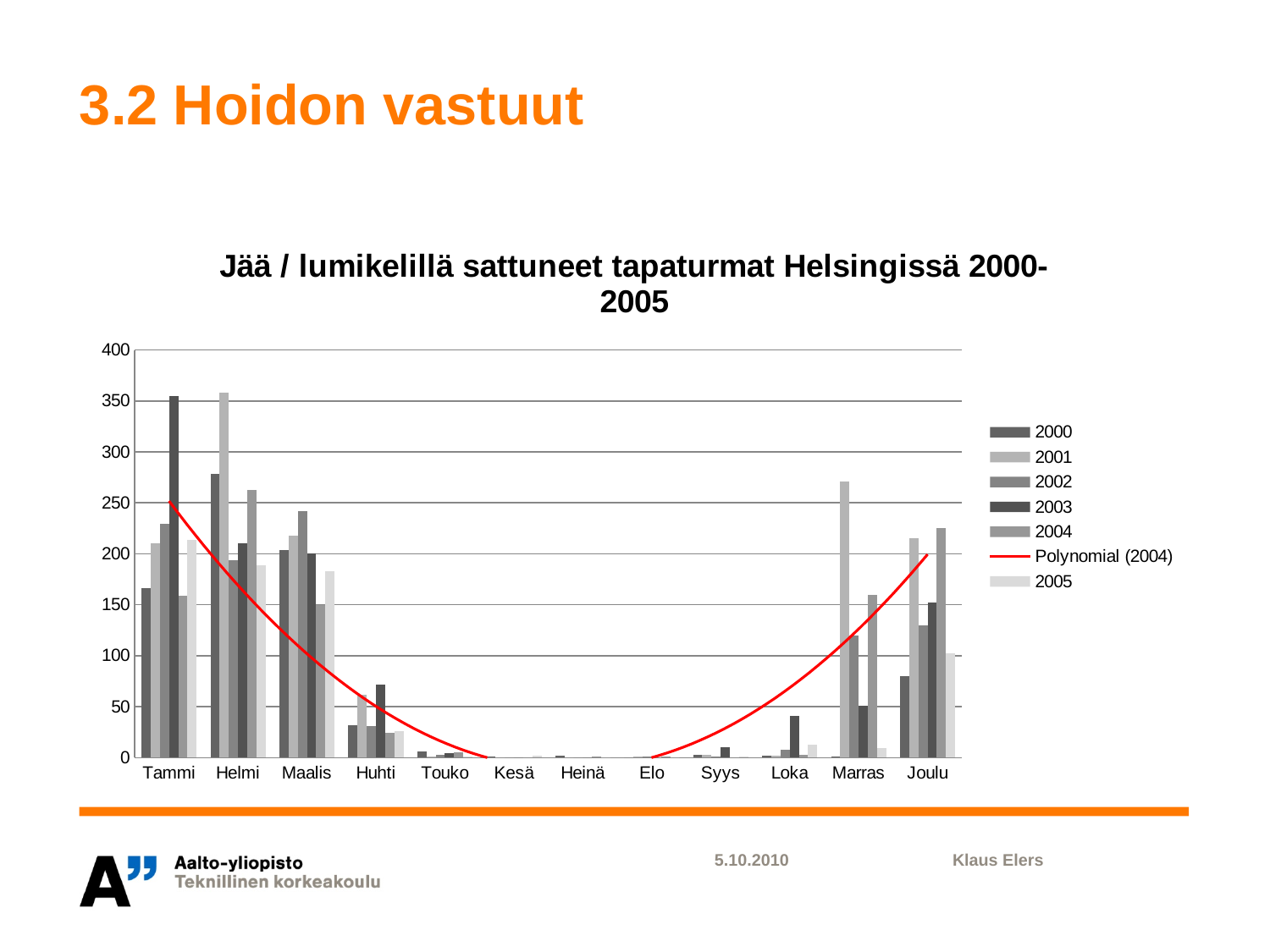
Is the value for 2003 in Tammi greater or less than 300? greater How many entries does the chart's legend list? 7 Is the value for 2001 in Marras greater or less than 250? greater How many month categories are shown on the x axis of the chart? 12 Is the value for 2004 in Maalis greater or less than 200? less What kind of chart is shown on the slide? bar chart In which month is the 2003 bar highest? Tammi In Tammi, which is larger: the value for 2000 or the value for 2003? 2003 What is the title of the chart? Jää / lumikelillä sattuneet tapaturmat Helsingissä 2000-2005 Which legend entry is drawn as a red line rather than bars? Polynomial (2004) Which series has the highest bar in Marras? 2001